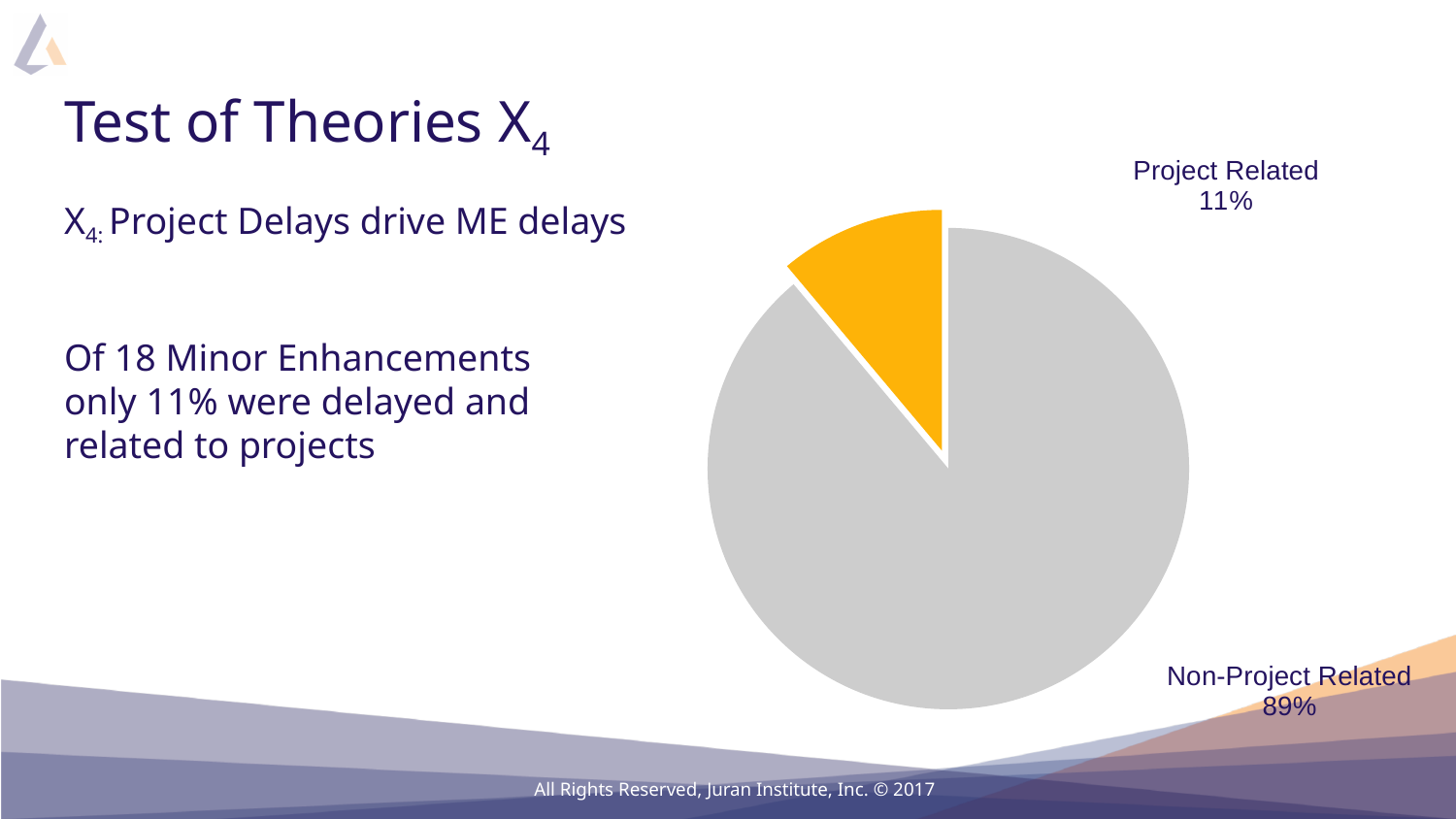
Which slice of the pie is the largest? Non-Project Related How many slices does the pie chart have? 2 What kind of chart is shown on the slide? pie chart Which slice of the pie is the smallest? Project Related What colour is the Project Related slice? orange What share of the pie is Project Related? 11% What colour is the Non-Project Related slice? grey What is the difference in percentage points between the Non-Project Related and Project Related slices? 78 Which is larger, the Project Related slice or the Non-Project Related slice? Non-Project Related What share of the pie is Non-Project Related? 89%